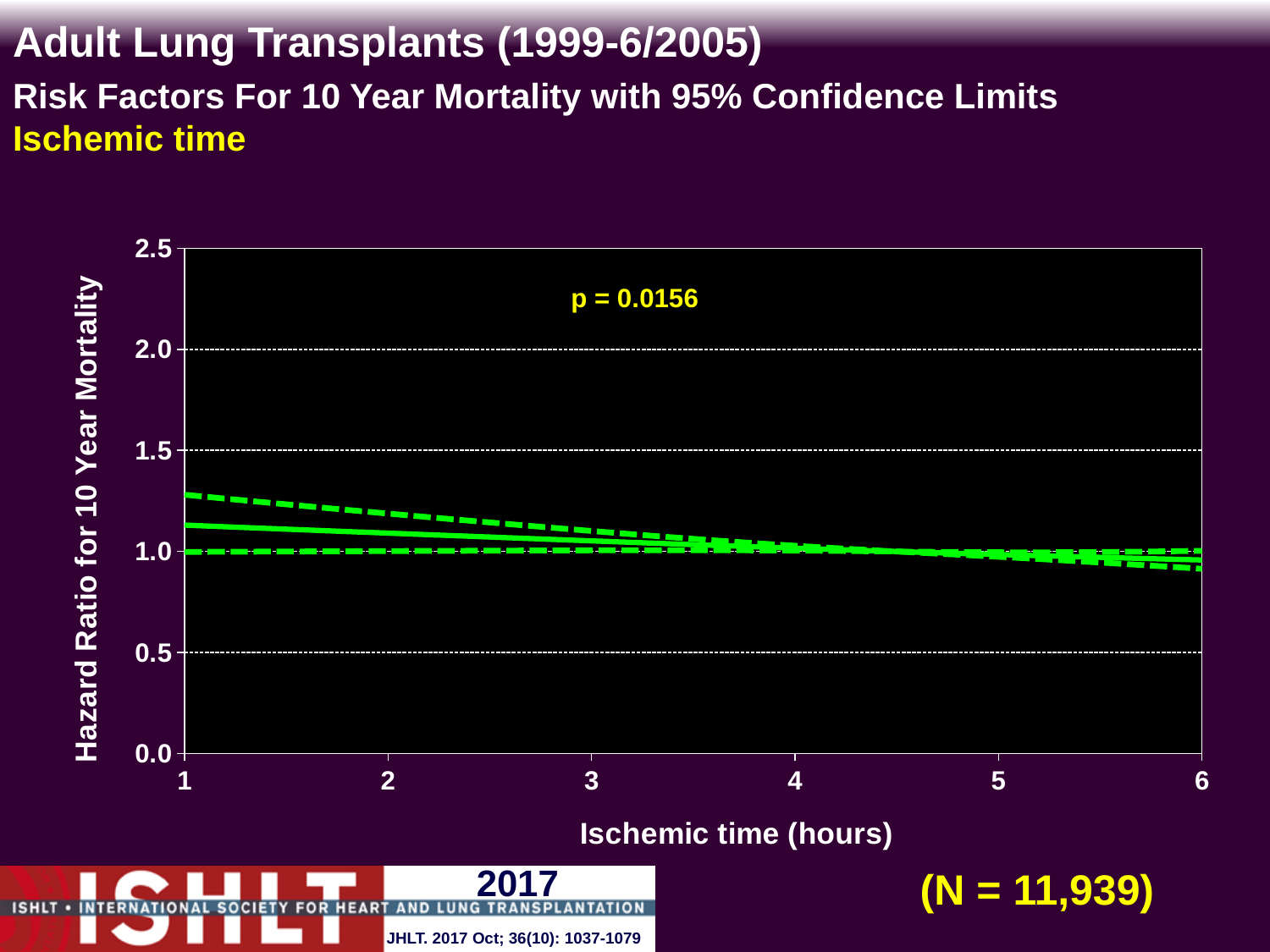
Is the upper 95% confidence limit at an ischemic time of 1 hour greater or less than 1.5? less Is the hazard ratio (solid line) at an ischemic time of 1 hour greater or less than 1.0? greater What p-value is printed on the chart? p = 0.0156 What kind of chart is shown on the slide? line chart What sample size (N) is shown on the slide? N = 11,939 How many labelled tick marks are on the x axis (ischemic time)? 6 Is the upper 95% confidence limit at an ischemic time of 1 hour greater or less than 1.0? greater Does the hazard ratio for 10 year mortality rise or fall as ischemic time increases from 1 to 6 hours? fall How many lines are plotted on the chart (the estimate plus its confidence limits)? 3